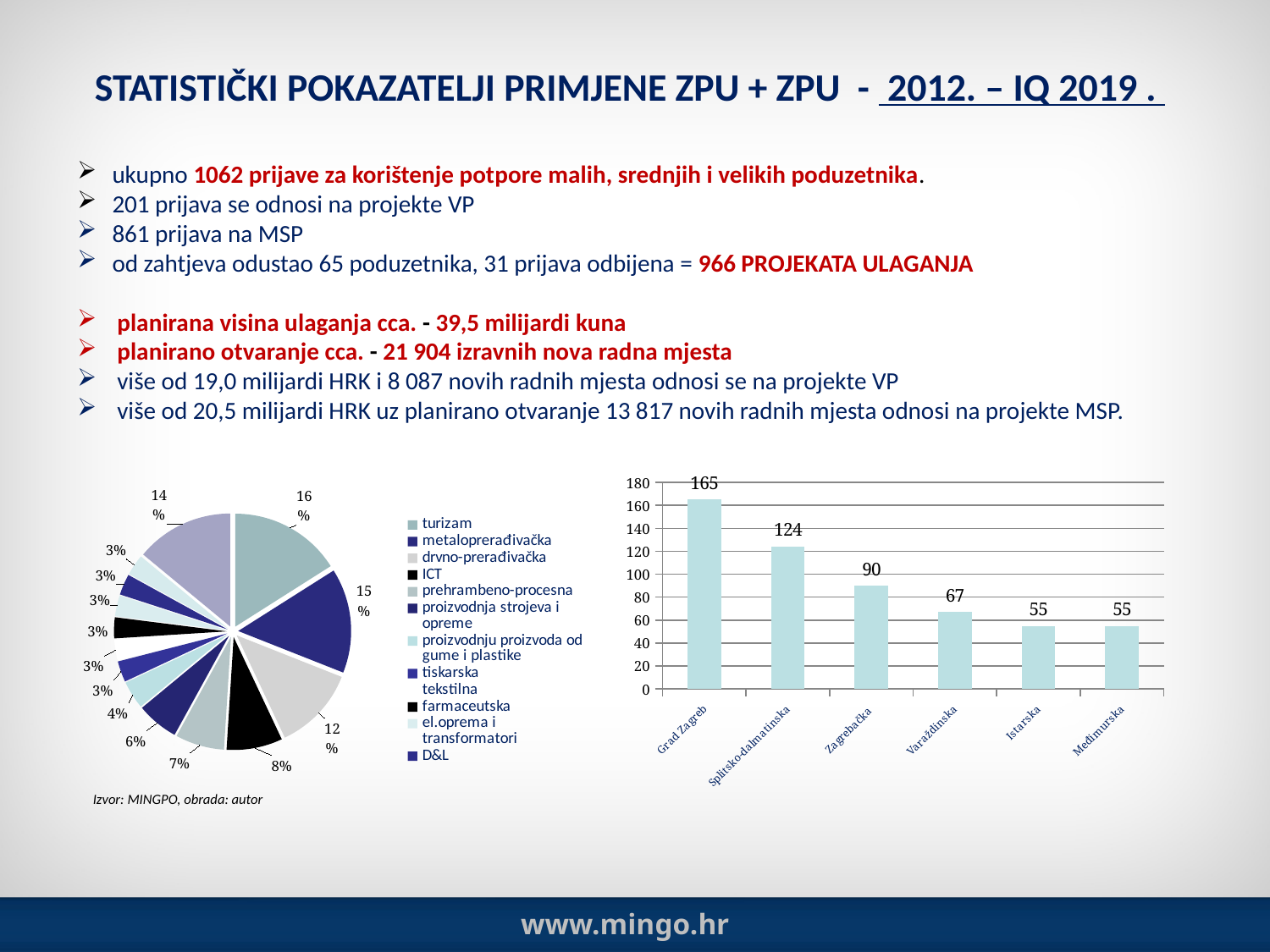
On the bar chart on the right, what is the value for Grad Zagreb? 165 On the bar chart on the right, which category has the highest value? Grad Zagreb What kind of chart is the chart on the left of the slide? pie chart On the bar chart on the right, what is the value for Splitsko-dalmatinska? 124 On the bar chart on the right, do the values rise or fall from left to right along the x axis? fall On the bar chart on the right, what is the difference between the values for Grad Zagreb and Splitsko-dalmatinska? 41 On the bar chart on the right, which is larger, the value for Zagrebačka or the value for Varaždinska? Zagrebačka On the bar chart on the right, what is the value for Varaždinska? 67 On the bar chart on the right, how many categories are shown on the x axis? 6 What kind of chart is the chart on the right of the slide? bar chart On the pie chart on the left, what share is labelled for turizam? 16% On the bar chart on the right, what is the difference between the values for Zagrebačka and Istarska? 35